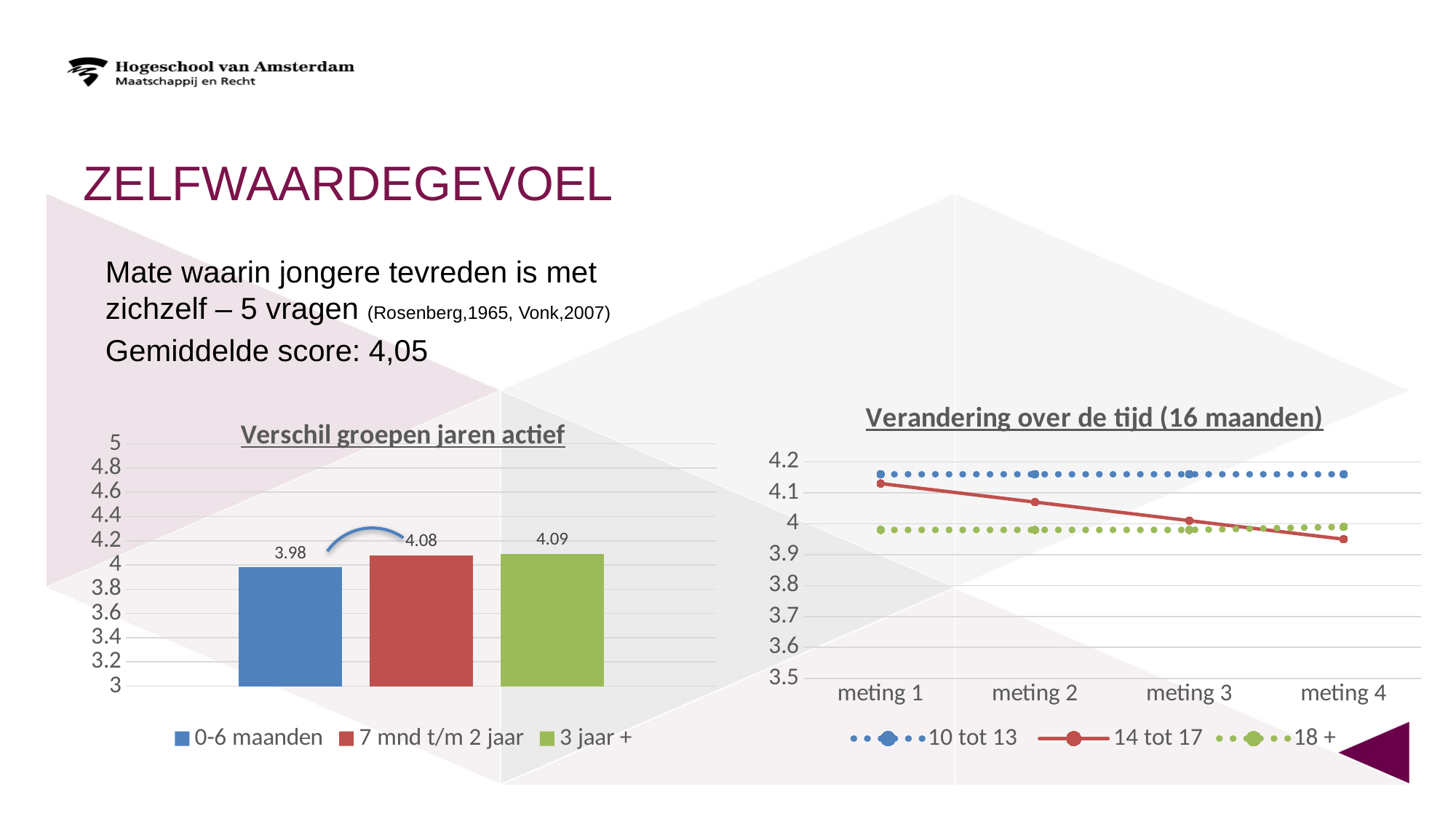
In the chart 'Verschil groepen jaren actief', how many bars are shown? 3 In the chart 'Verschil groepen jaren actief', what is the value for 7 mnd t/m 2 jaar? 4.08 In the chart 'Verandering over de tijd (16 maanden)', is the value for 10 tot 13 at meting 1 greater or less than 4.1? greater In the chart 'Verandering over de tijd (16 maanden)', does the 14 tot 17 series rise or fall from meting 1 to meting 4? Fall In the chart 'Verandering over de tijd (16 maanden)', how many measurement points are on the x axis? 4 In the chart 'Verandering over de tijd (16 maanden)', is the value for 14 tot 17 at meting 4 greater or less than 4? less What type of chart is 'Verschil groepen jaren actief'? Bar chart In the chart 'Verschil groepen jaren actief', what is the difference between the values for 3 jaar + and 0-6 maanden? 0.11 In the chart 'Verschil groepen jaren actief', what is the value for 3 jaar +? 4.09 In the chart 'Verschil groepen jaren actief', what is the value for 0-6 maanden? 3.98 In the chart 'Verschil groepen jaren actief', which group has the lowest value? 0-6 maanden In the chart 'Verandering over de tijd (16 maanden)', how many series does the legend list? 3